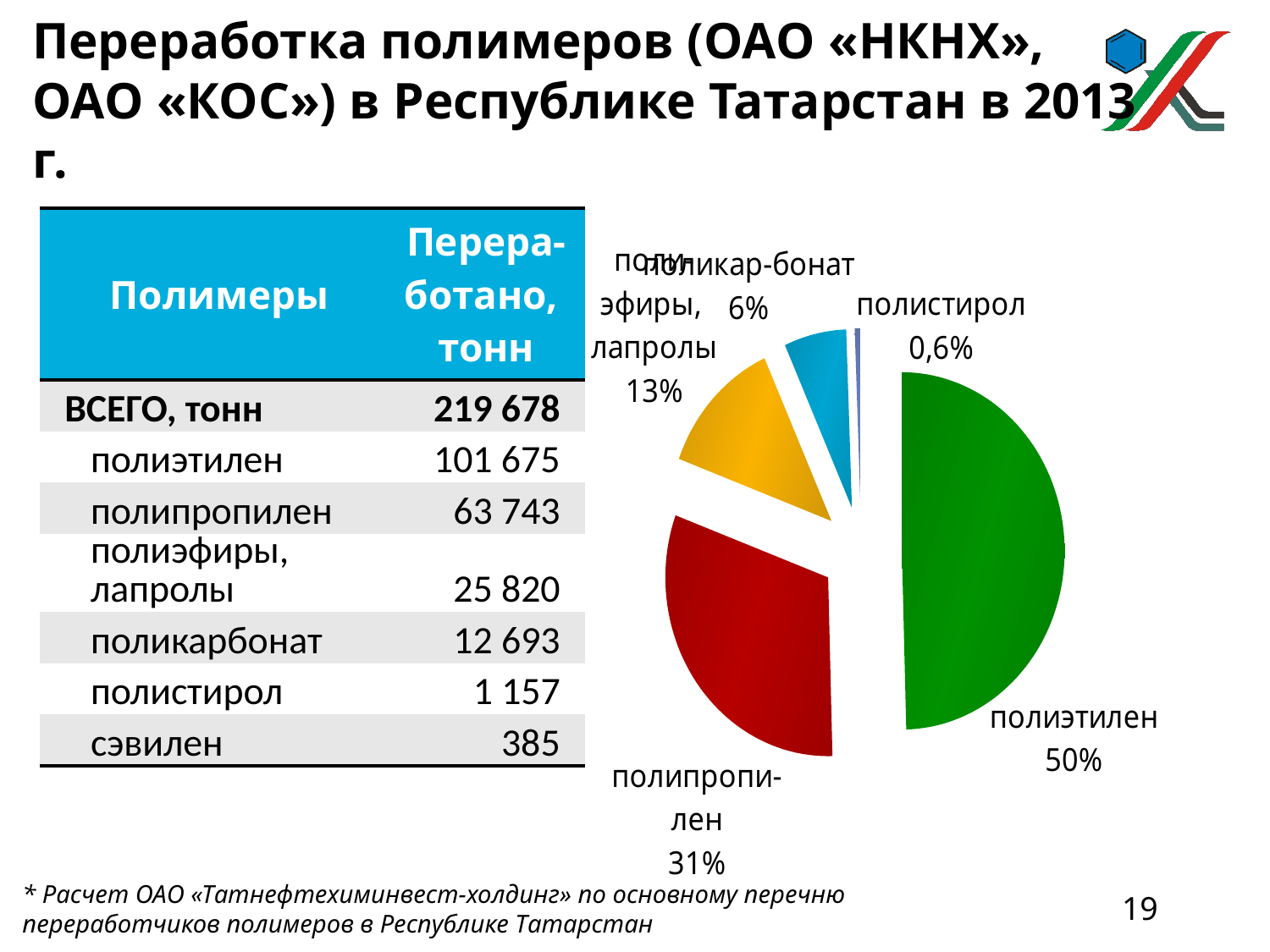
By how many percentage points does the полиэтилен share exceed the полипропилен share in the pie chart? 19% What share of the pie chart does полиэфиры, лапролы have? 13% What kind of chart is shown on the slide? pie chart What share of the pie chart does поликарбонат have? 6% What share of the pie chart does полиэтилен have? 50% Which slice is larger in the pie chart: полипропилен or полиэфиры, лапролы? полипропилен What colour is the полипропилен slice in the pie chart? red Which labelled polymer has the smallest slice in the pie chart? полистирол Which polymer has the largest slice in the pie chart? полиэтилен What colour is the полиэтилен slice in the pie chart? green